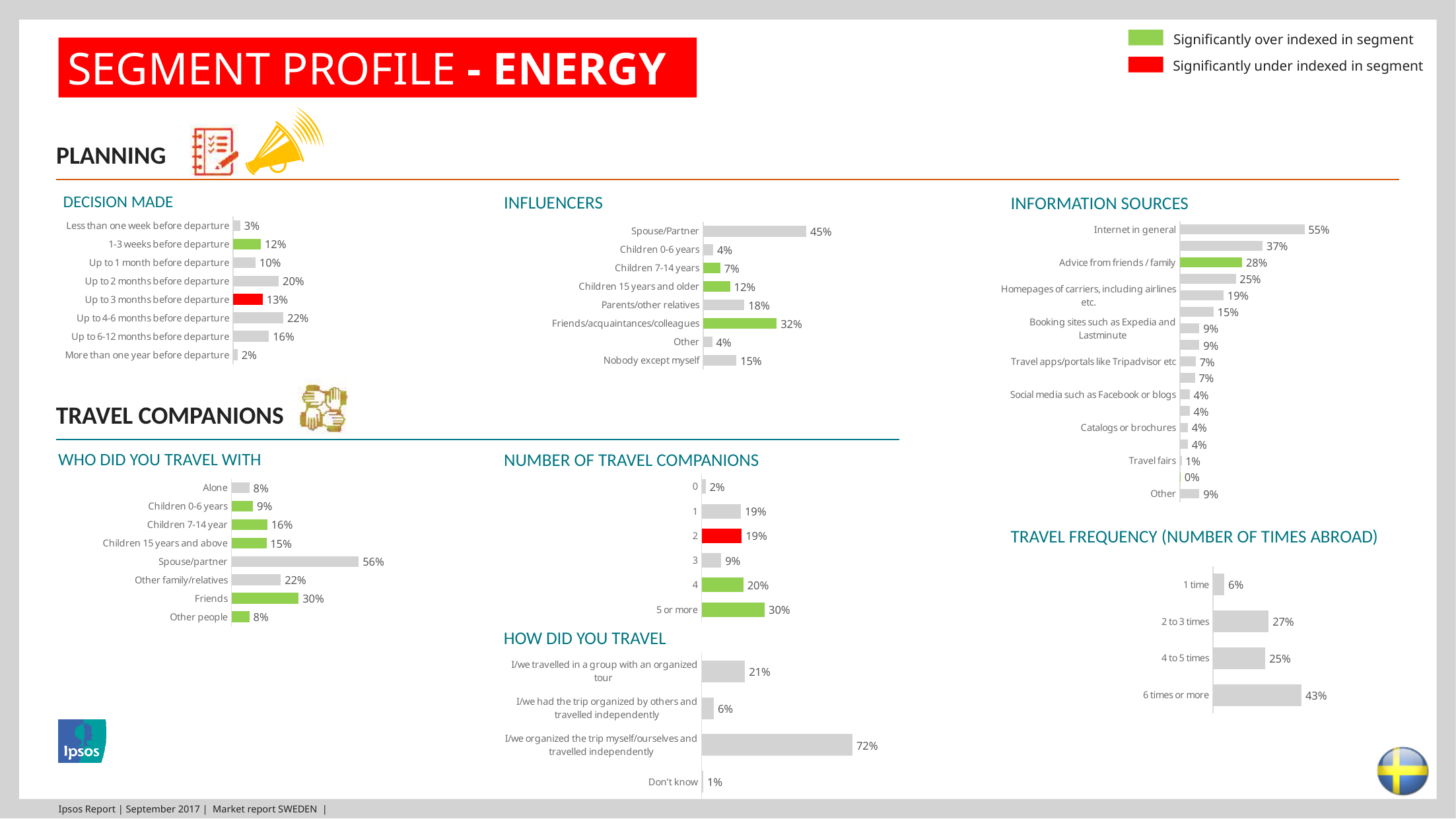
In the WHO DID YOU TRAVEL WITH chart, what is the value for Spouse/partner? 56% In the DECISION MADE chart, what is the value for 'Up to 4-6 months before departure'? 22% In the INFLUENCERS chart, what is the difference between Friends/acquaintances/colleagues and Parents/other relatives? 14% In the INFLUENCERS chart, what is the value for Spouse/Partner? 45% In the NUMBER OF TRAVEL COMPANIONS chart, which is larger, the value for 3 or the value for 4? 4 What type of chart is the TRAVEL FREQUENCY (NUMBER OF TIMES ABROAD) chart? Bar chart In the HOW DID YOU TRAVEL chart, which category has the lowest value? Don't know In the INFORMATION SOURCES chart, which category has the highest value? Internet in general In the NUMBER OF TRAVEL COMPANIONS chart, what is the value for '5 or more'? 30% How many categories are shown in the WHO DID YOU TRAVEL WITH chart? 8 In the DECISION MADE chart, which category has the highest value? Up to 4-6 months before departure In the TRAVEL FREQUENCY (NUMBER OF TIMES ABROAD) chart, what is the value for '6 times or more'? 43%